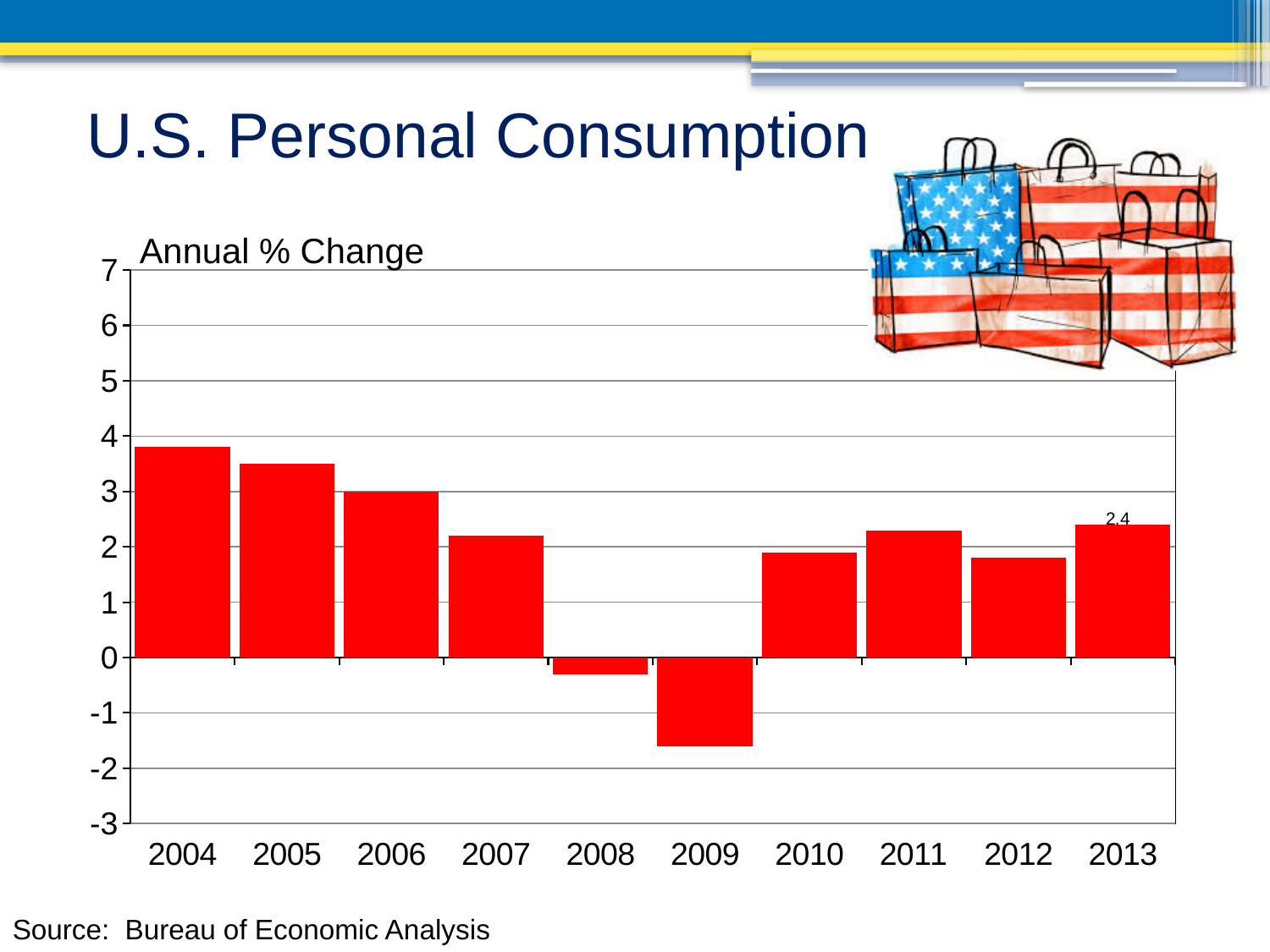
Do the values rise or fall from 2004 to 2007? Fall What is the annual % change in U.S. personal consumption for 2013? 2.4 Which year has the larger annual % change, 2011 or 2012? 2011 How many years show a negative annual % change? 2 What is the title of the slide containing the chart? U.S. Personal Consumption What kind of chart is used to show U.S. personal consumption? Bar chart Which year has the highest annual % change in personal consumption? 2004 Is the value for 2004 greater or less than 3? greater Which year has the larger annual % change, 2005 or 2007? 2005 Which year has the lowest annual % change in personal consumption? 2009 Is the value for 2009 greater or less than -1? less How many years are shown on the x axis of the chart? 10